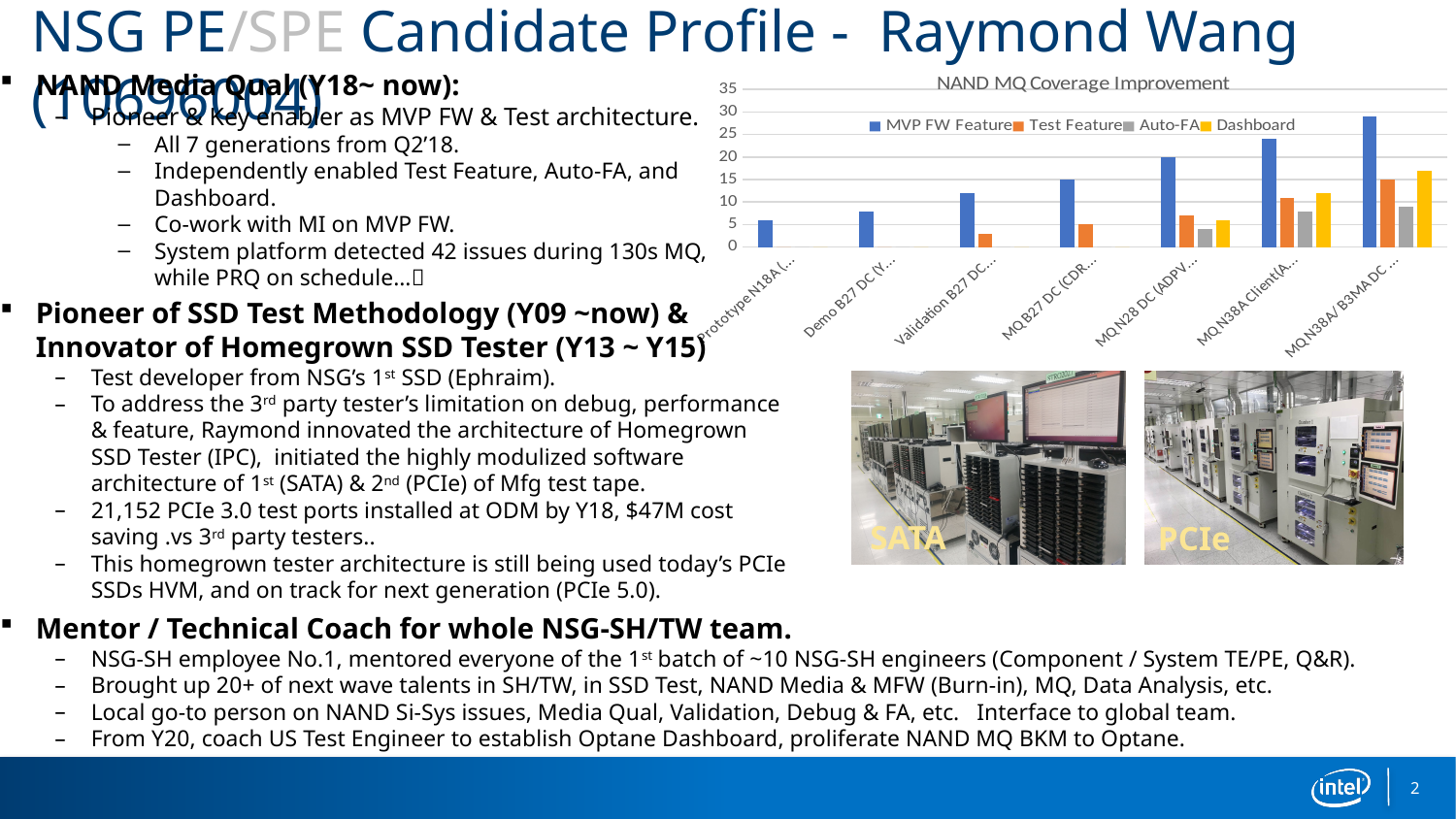
In the "NAND MQ Coverage Improvement" chart, which category has the highest MVP FW Feature value? MQ N38A/B3MA DC In the "NAND MQ Coverage Improvement" chart, is the Test Feature value for Validation B27 DC greater or less than 5? less In the "NAND MQ Coverage Improvement" chart, is the MVP FW Feature value for Prototype N18A greater or less than 10? less How many series does the legend of the "NAND MQ Coverage Improvement" chart list? 4 In the "NAND MQ Coverage Improvement" chart, is the MVP FW Feature value for MQ N38A/B3MA DC greater or less than 25? greater In the "NAND MQ Coverage Improvement" chart, for MQ N38A/B3MA DC, which is larger: the MVP FW Feature value or the Dashboard value? MVP FW Feature What kind of chart is the "NAND MQ Coverage Improvement" chart? Bar chart In the "NAND MQ Coverage Improvement" chart, which category has the lowest MVP FW Feature value? Prototype N18A In the "NAND MQ Coverage Improvement" chart, do the MVP FW Feature values rise or fall from left to right along the x axis? Rise How many categories are shown on the x axis of the "NAND MQ Coverage Improvement" chart? 7 In the "NAND MQ Coverage Improvement" chart, for MQ N38A/B3MA DC, which is larger: the Dashboard value or the Auto-FA value? Dashboard